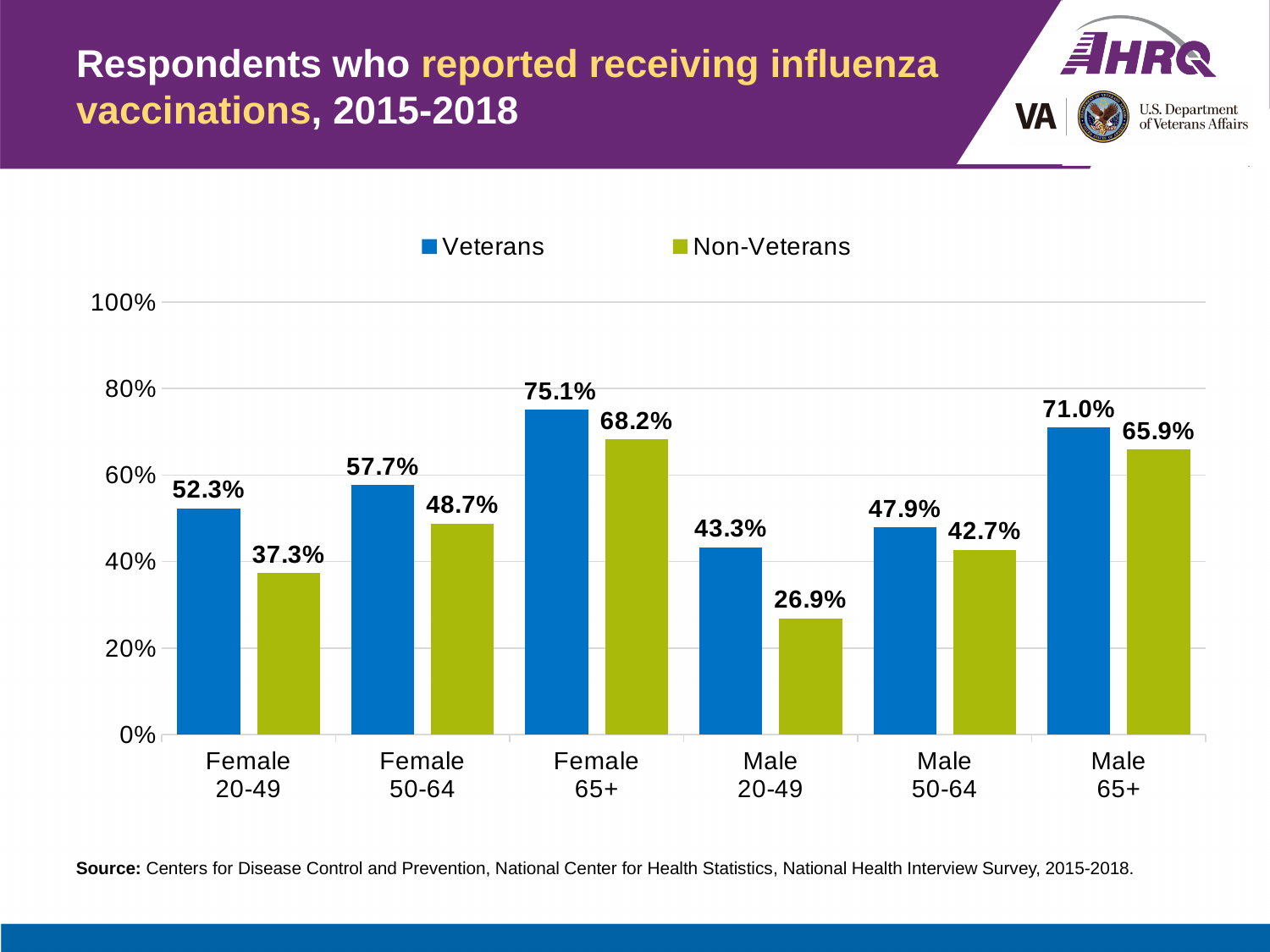
Which category has the lowest Non-Veterans value? Male 20-49 What kind of chart is shown on the slide? Bar chart Which is larger: the Non-Veterans value for Female 50-64 or the Non-Veterans value for Male 50-64? Female 50-64 How many series does the legend list? 2 What is the difference between the Veterans and Non-Veterans values for the Female 20-49 group? 15.0% Is the Veterans value for Male 20-49 greater or less than 40%? greater What is the value for Non-Veterans in the Male 20-49 group? 26.9% How many categories are shown on the x axis? 6 What is the value for Veterans in the Male 50-64 group? 47.9% What is the difference between the Veterans and Non-Veterans values for the Male 65+ group? 5.1% Which category has the highest Veterans value? Female 65+ What percentage of Veterans in the Female 65+ group reported receiving influenza vaccinations? 75.1%